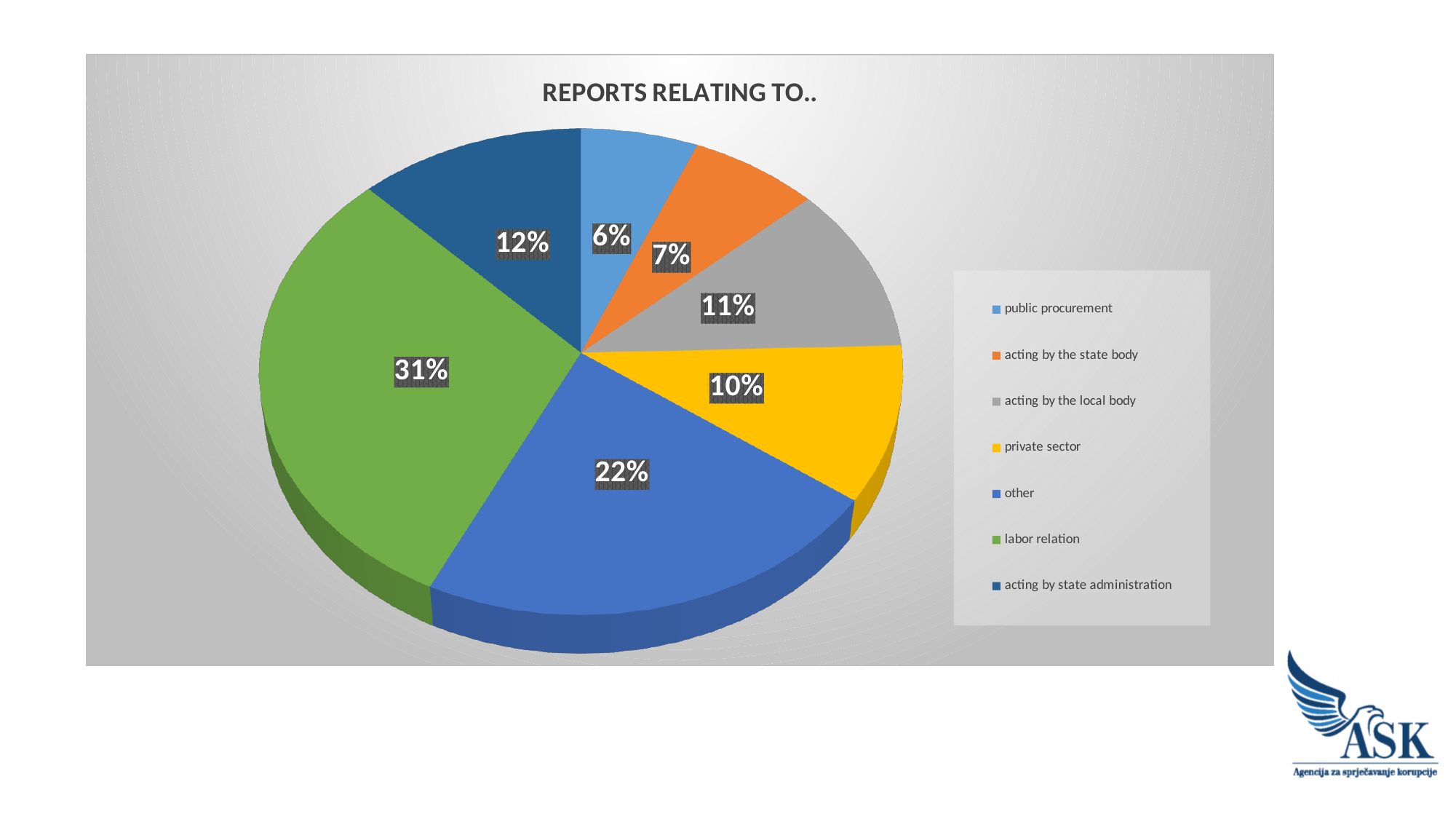
What kind of chart is shown on the slide? pie chart What share of reports relates to acting by the local body? 11% Which is larger, the share for acting by the state body or the share for acting by the local body? acting by the local body What share of reports relates to the private sector? 10% What share of reports relates to public procurement? 6% Which category has the largest share of reports? labor relation What is the difference in percentage points between the labor relation share and the other share? 9 How many categories does the legend list? 7 Which category has the smallest share of reports? public procurement What is the title of the chart? REPORTS RELATING TO..